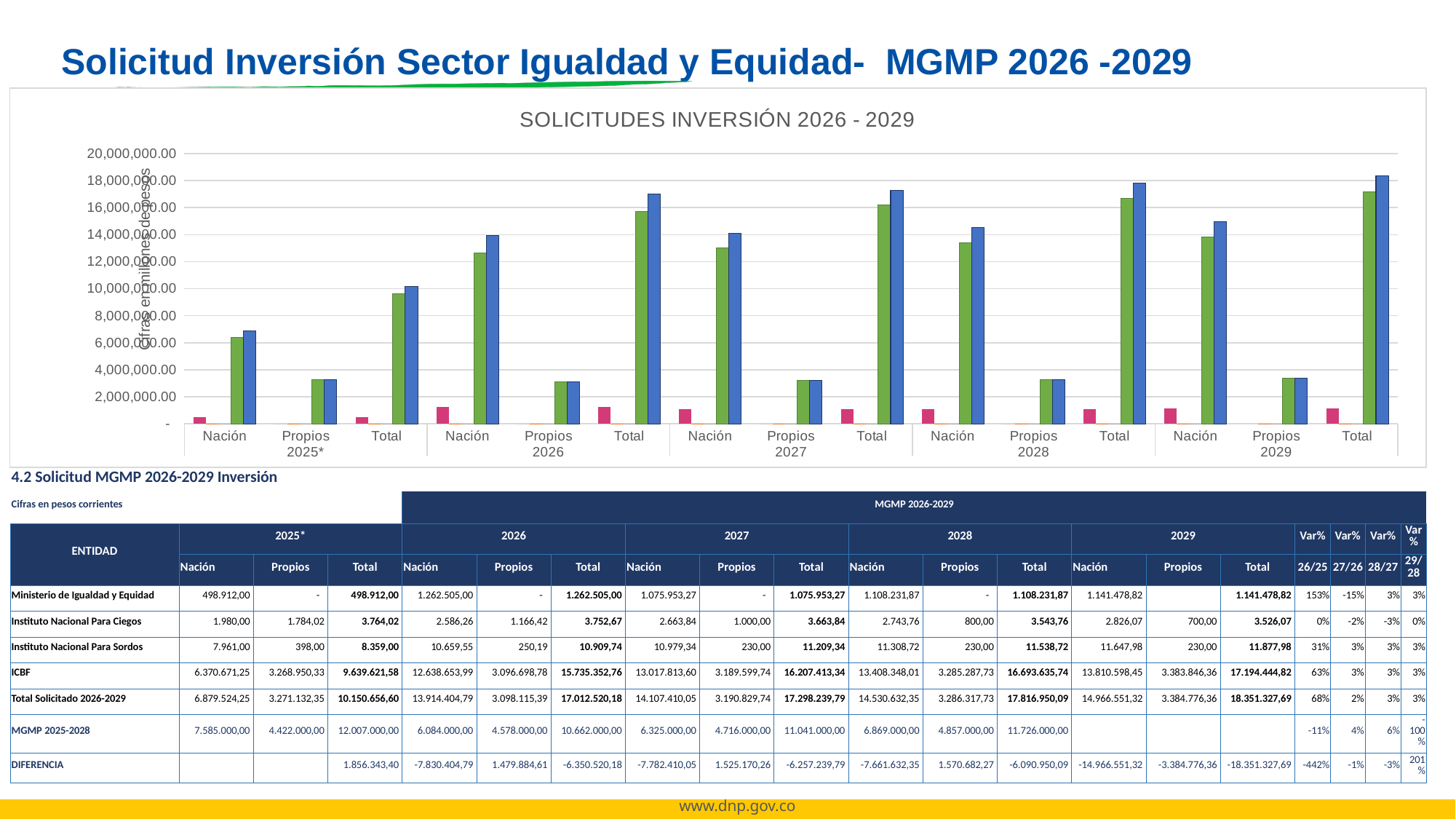
Is the green bar in the Nación 2026 group greater or less than 12,000,000.00? greater In which year does the Total group have the shortest bars on the chart? 2025* What kind of chart is shown on the slide? Bar chart What is the highest value shown on the chart's vertical axis? 20,000,000.00 In 2026, which group has taller green and blue bars, Nación or Propios? Nación How many category groups (Nación/Propios/Total labels) are shown along the x axis of the chart? 15 How many years are shown along the x axis of the chart? 5 What is the title of the chart? SOLICITUDES INVERSIÓN 2026 - 2029 Is the tallest bar in the Total 2029 group greater or less than 16,000,000.00? greater Is the green bar in the Propios 2026 group greater or less than 2,000,000.00? greater Do the tallest bars in the Total groups rise or fall from 2025* to 2029? Rise In which year does the Total group have the tallest bars on the chart? 2029